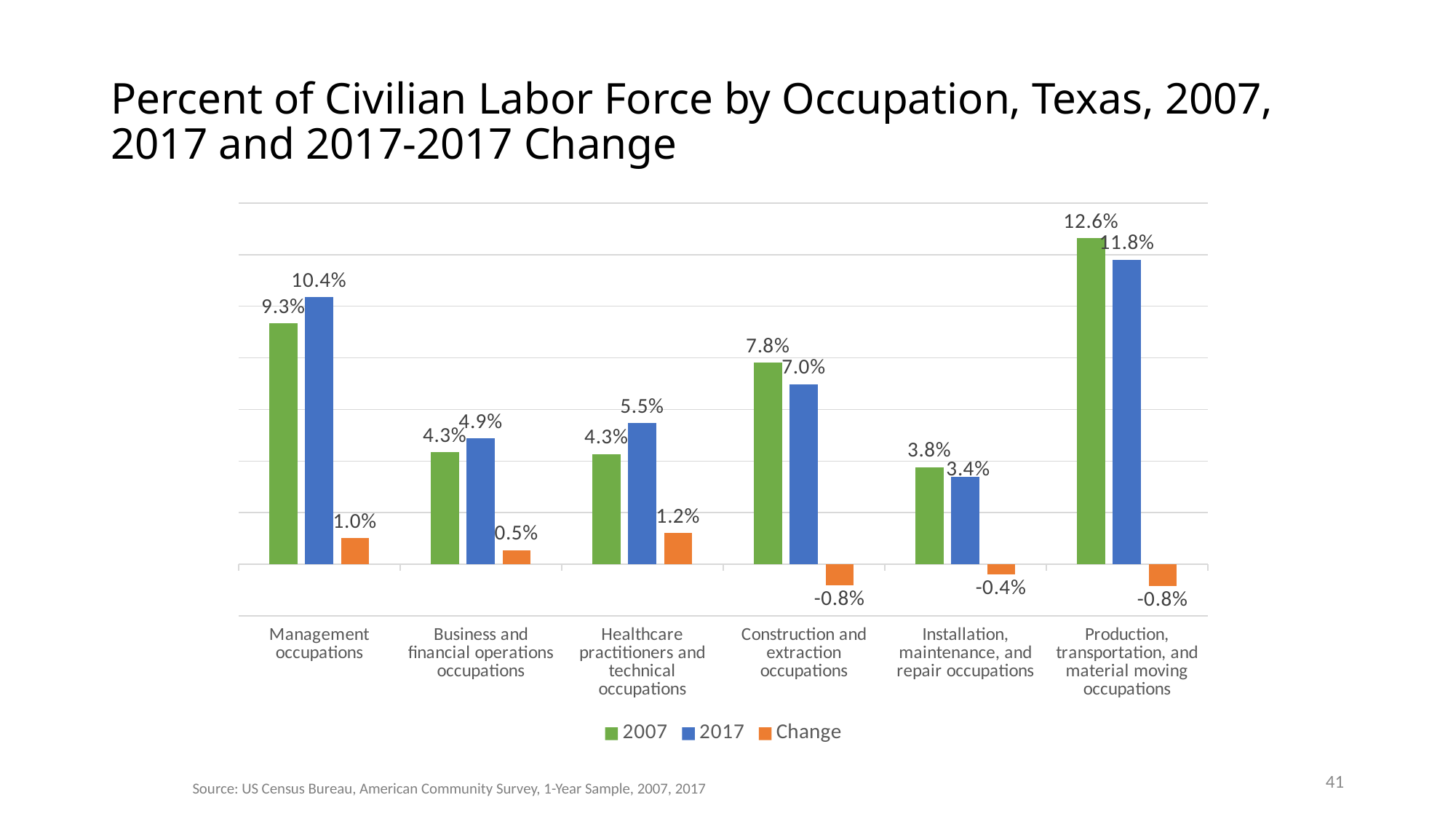
Which is larger for Installation, maintenance, and repair occupations: the 2007 value or the 2017 value? 2007 What colour represents the Change series in the legend? Orange What was the 2017 value for Management occupations? 10.4% Which occupation category has the lowest 2007 value? Installation, maintenance, and repair occupations How many series does the legend list? 3 Which occupation category has the largest negative Change value? Construction and extraction occupations and Production, transportation, and material moving occupations (both -0.8%) What is the Change value for Healthcare practitioners and technical occupations? 1.2% What kind of chart is shown on the slide? Bar chart What was the 2007 value for Construction and extraction occupations? 7.8% What is the difference between the 2007 and 2017 values for Business and financial operations occupations? 0.6% Which occupation category has the highest 2017 value? Production, transportation, and material moving occupations How many occupation categories are shown on the x axis? 6